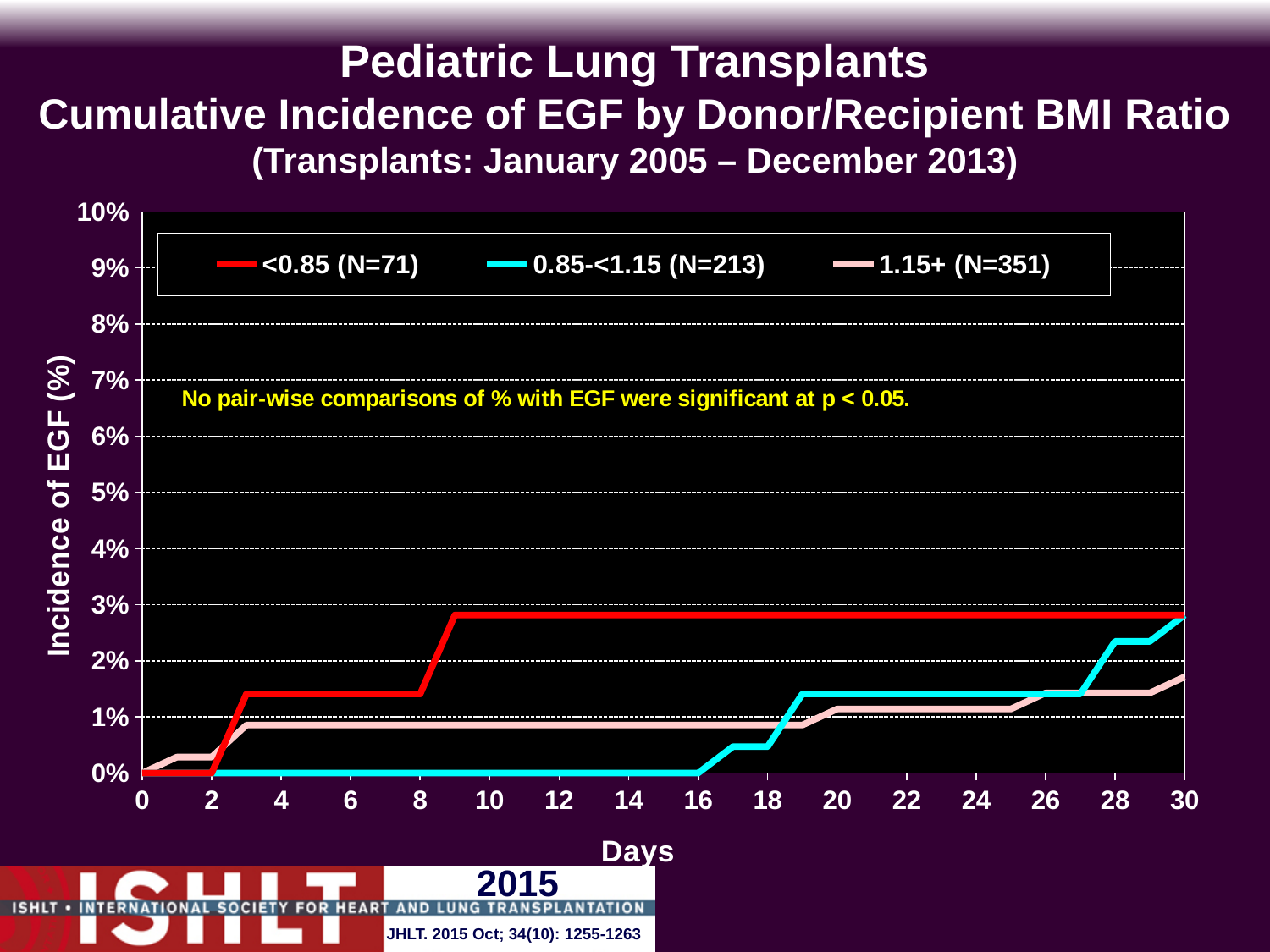
Is the value for the 1.15+ (N=351) series at day 30 greater or less than 2%? less Does the cumulative incidence for the 0.85-<1.15 (N=213) series rise or fall from day 16 to day 30? rise What does the annotation inside the chart say about pair-wise comparisons? No pair-wise comparisons of % with EGF were significant at p < 0.05. Is the value for the <0.85 (N=71) series at day 30 greater or less than 2%? greater Which series has the highest cumulative incidence of EGF at day 10? <0.85 (N=71) Is the value for the 0.85-<1.15 (N=213) series at day 20 greater or less than 1%? greater What kind of chart is shown on the slide? line chart How many series does the legend list? 3 At day 30, which is larger: the value for <0.85 (N=71) or the value for 1.15+ (N=351)? <0.85 (N=71) Which series has the lowest cumulative incidence of EGF at day 10? 0.85-<1.15 (N=213) Which series in the legend has the largest number of patients (N)? 1.15+ (N=351)